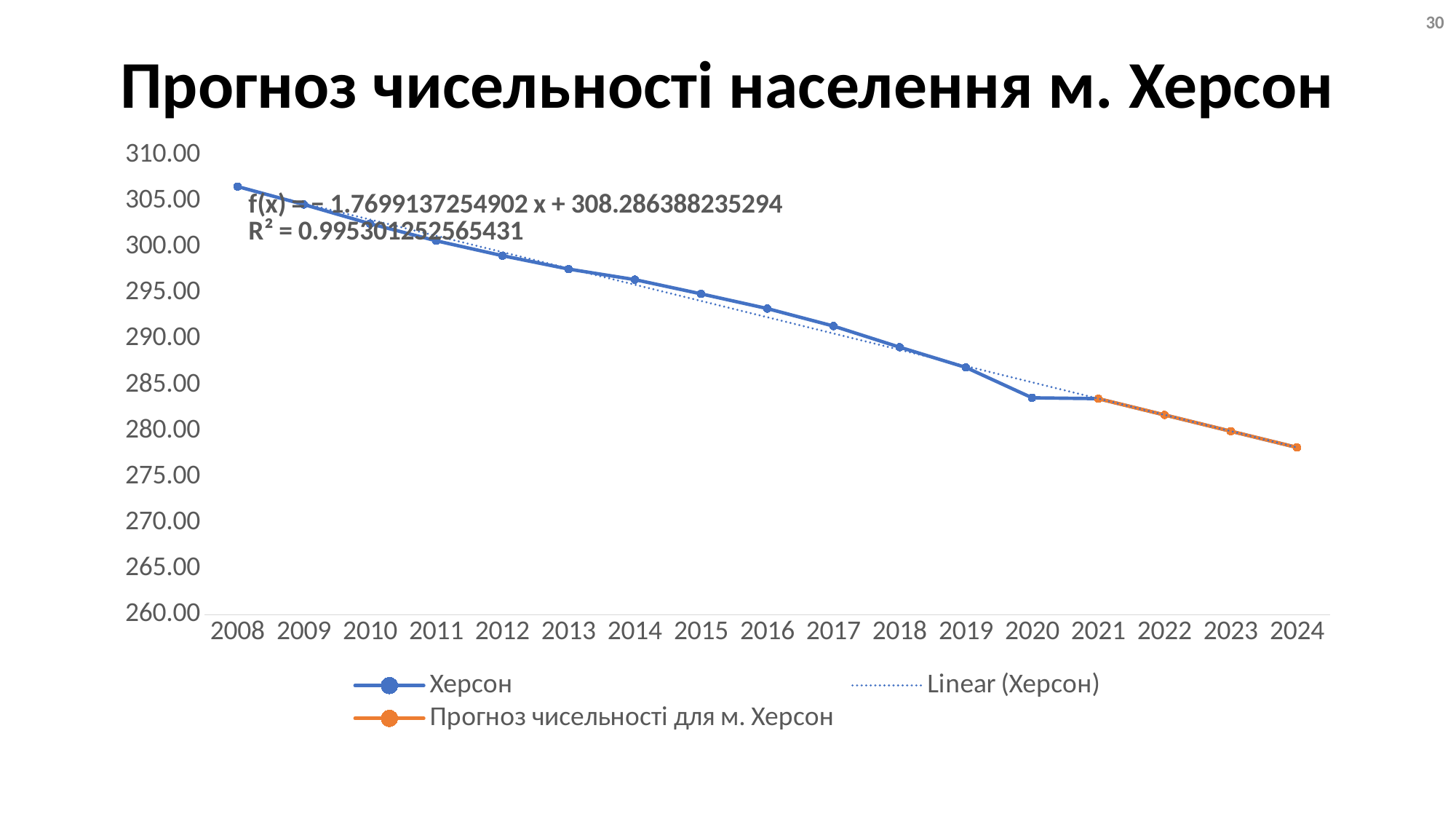
What kind of chart is shown on the slide? line chart What is the title of the chart? Прогноз чисельності населення м. Херсон What R² value is printed on the chart? 0.995301252565431 Is the value for 2016 greater or less than 295? less How many years are shown on the x axis? 17 Do the values rise or fall from 2008 to 2024? fall Which is larger, the value for 2012 or the value for 2020? 2012 Is the value for 2008 greater or less than 305? greater How many series does the legend list? 3 Is the value for 2024 greater or less than 280? less Which year has the highest value on the chart? 2008 Which year has the lowest value on the chart? 2024